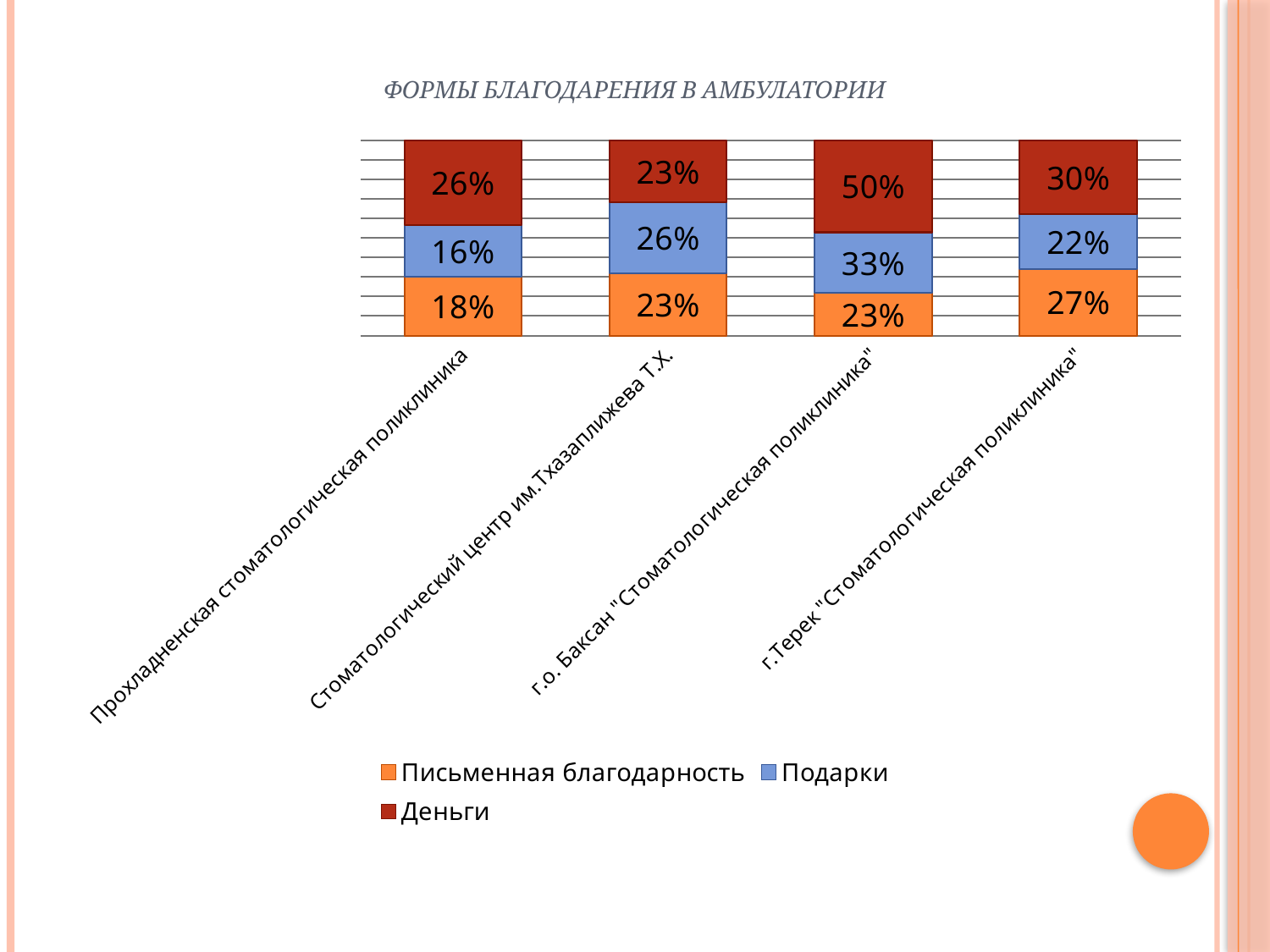
What is the title of the chart? ФОРМЫ БЛАГОДАРЕНИЯ В АМБУЛАТОРИИ What is the value of Деньги for г.о. Баксан "Стоматологическая поликлиника"? 50% What is the value of Письменная благодарность for Прохладненская стоматологическая поликлиника? 18% Which clinic has the highest value for Деньги? г.о. Баксан "Стоматологическая поликлиника" How many series does the legend list? 3 What kind of chart is shown on the slide? stacked bar chart What is the value of Письменная благодарность for г.Терек "Стоматологическая поликлиника"? 27% Which is larger: the Подарки value for г.о. Баксан "Стоматологическая поликлиника" or for г.Терек "Стоматологическая поликлиника"? г.о. Баксан "Стоматологическая поликлиника" Which clinic has the lowest value for Подарки? Прохладненская стоматологическая поликлиника What is the value of Подарки for Стоматологический центр им.Тхазаплижева Т.Х.? 26% What is the difference between the Деньги values for г.о. Баксан "Стоматологическая поликлиника" and г.Терек "Стоматологическая поликлиника"? 20% How many categories (clinics) are shown on the x axis? 4